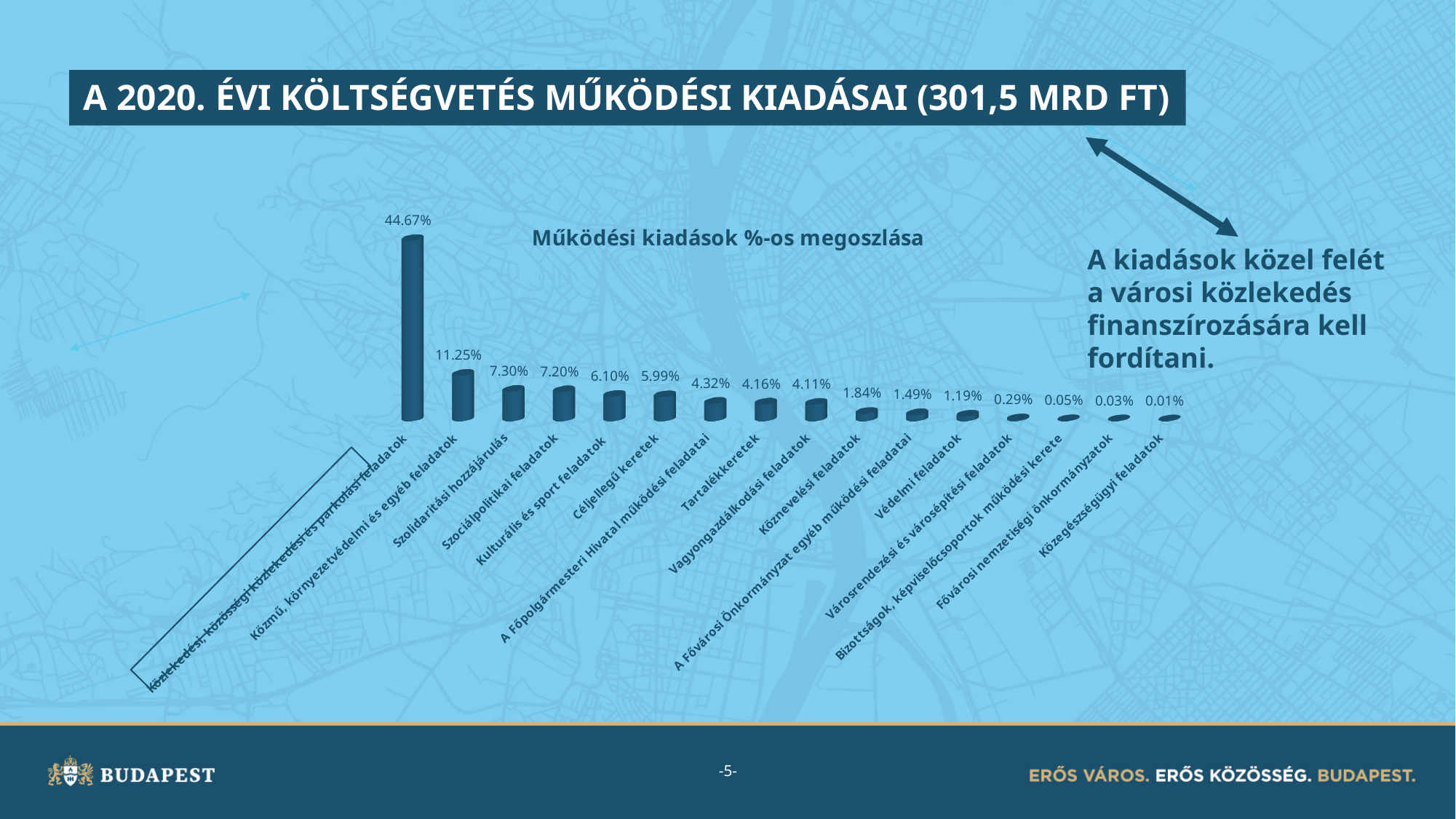
Do the values rise or fall from left to right along the x axis? fall Which is larger, the value for Kulturális és sport feladatok or the value for Céljellegű keretek? Kulturális és sport feladatok How many categories are shown in the chart? 16 Which category has the lowest value? Közegészségügyi feladatok What kind of chart is shown on the slide? bar chart What is the value for Közmű, környezetvédelmi és egyéb feladatok? 11.25% What is the title of the chart on the slide? Működési kiadások %-os megoszlása What is the value for Köznevelési feladatok? 1.84% What is the difference between the values for Szolidaritási hozzájárulás and Szociálpolitikai feladatok? 0.10% Which category has the highest value? Közlekedési, közösségi közlekedési és parkolási feladatok What is the value for Tartalékkeretek? 4.16% What is the value for Közlekedési, közösségi közlekedési és parkolási feladatok? 44.67%